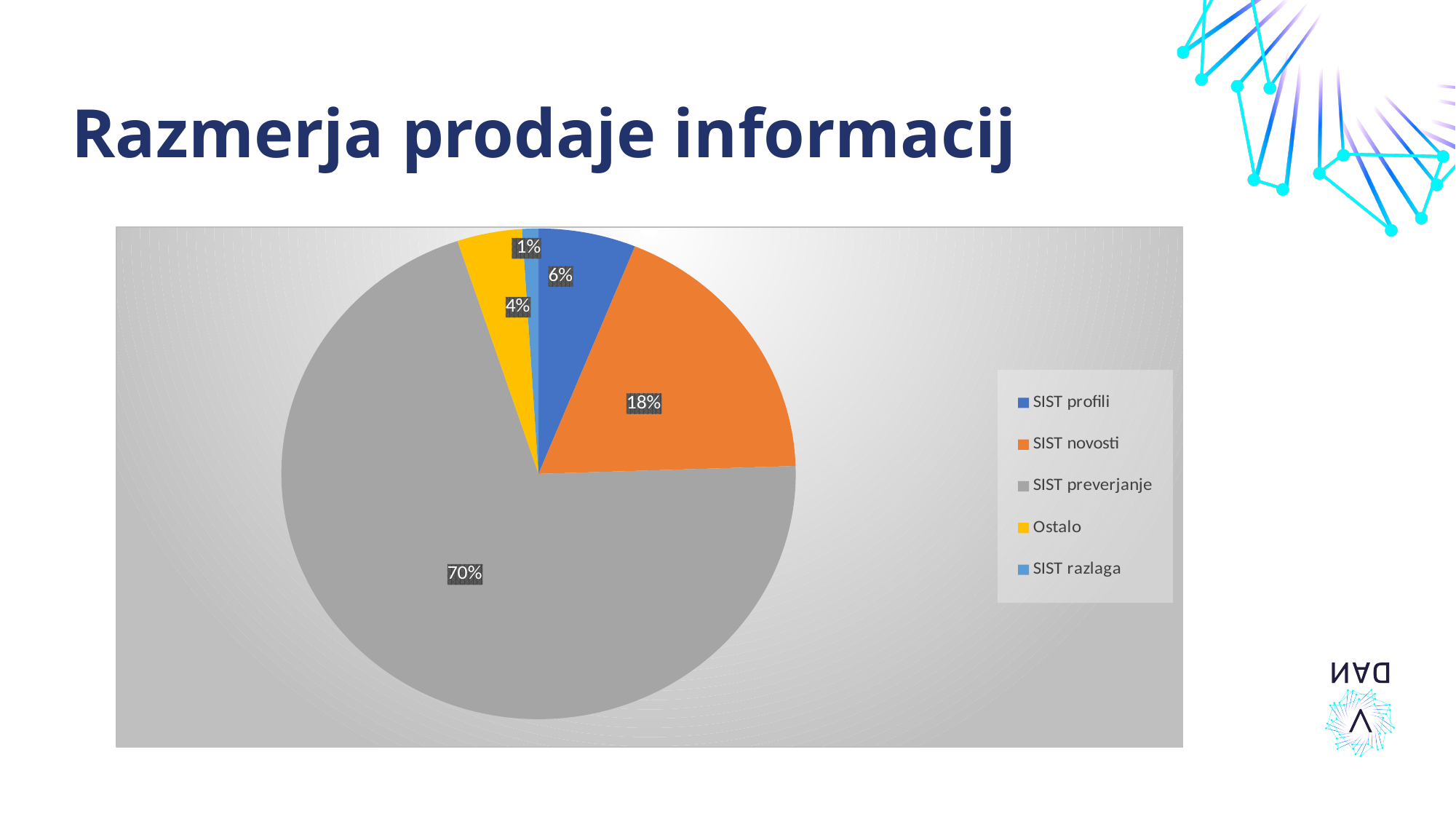
What colour is the slice for SIST novosti? orange What share of the pie does Ostalo have? 4% Which category has the largest slice of the pie? SIST preverjanje Which is larger, the share of SIST profili or the share of Ostalo? SIST profili What share of the pie does SIST novosti have? 18% What share of the pie does SIST preverjanje have? 70% What type of chart is shown on the slide? pie chart Which category has the smallest slice of the pie? SIST razlaga What is the difference between the shares of SIST preverjanje and SIST novosti? 52% How many categories does the legend list? 5